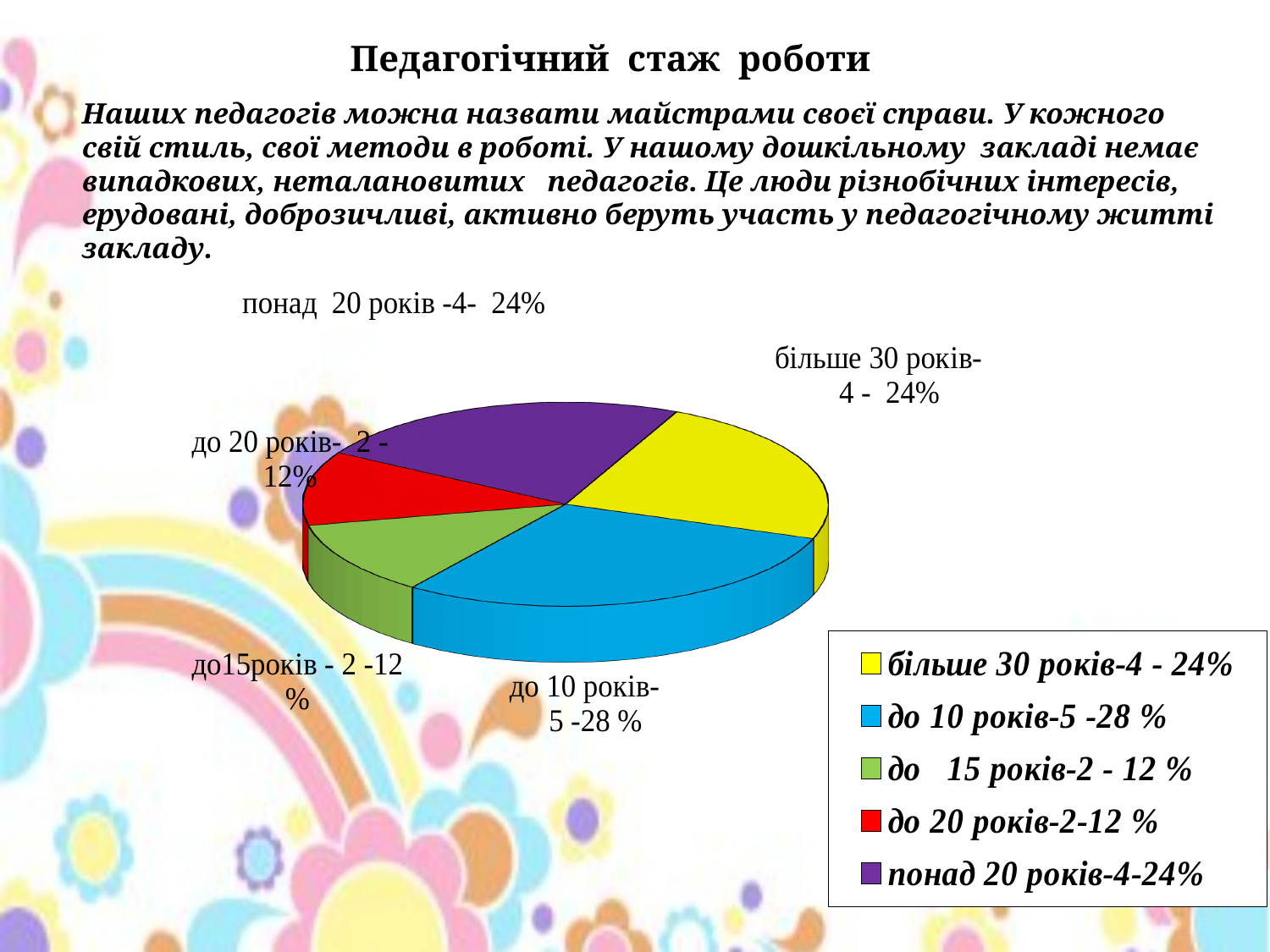
How many teachers are in the 'до 15 років' category? 2 How many slices does the pie chart have? 5 What is the difference in percentage points between the 'до 10 років' share and the 'до 20 років' share? 16 What percentage share does the slice 'більше 30 років' have? 24% What percentage share does the slice 'до 10 років' have? 28 % Which is larger: the share for 'до 10 років' or the share for 'до 15 років'? до 10 років Which colour represents 'більше 30 років' in the pie chart? yellow What kind of chart is shown on the slide? pie chart How many teachers are in the 'понад 20 років' category? 4 What percentage share does the slice 'до 20 років' have? 12 % How many entries does the legend of the pie chart list? 5 Which category has the largest share of the pie? до 10 років